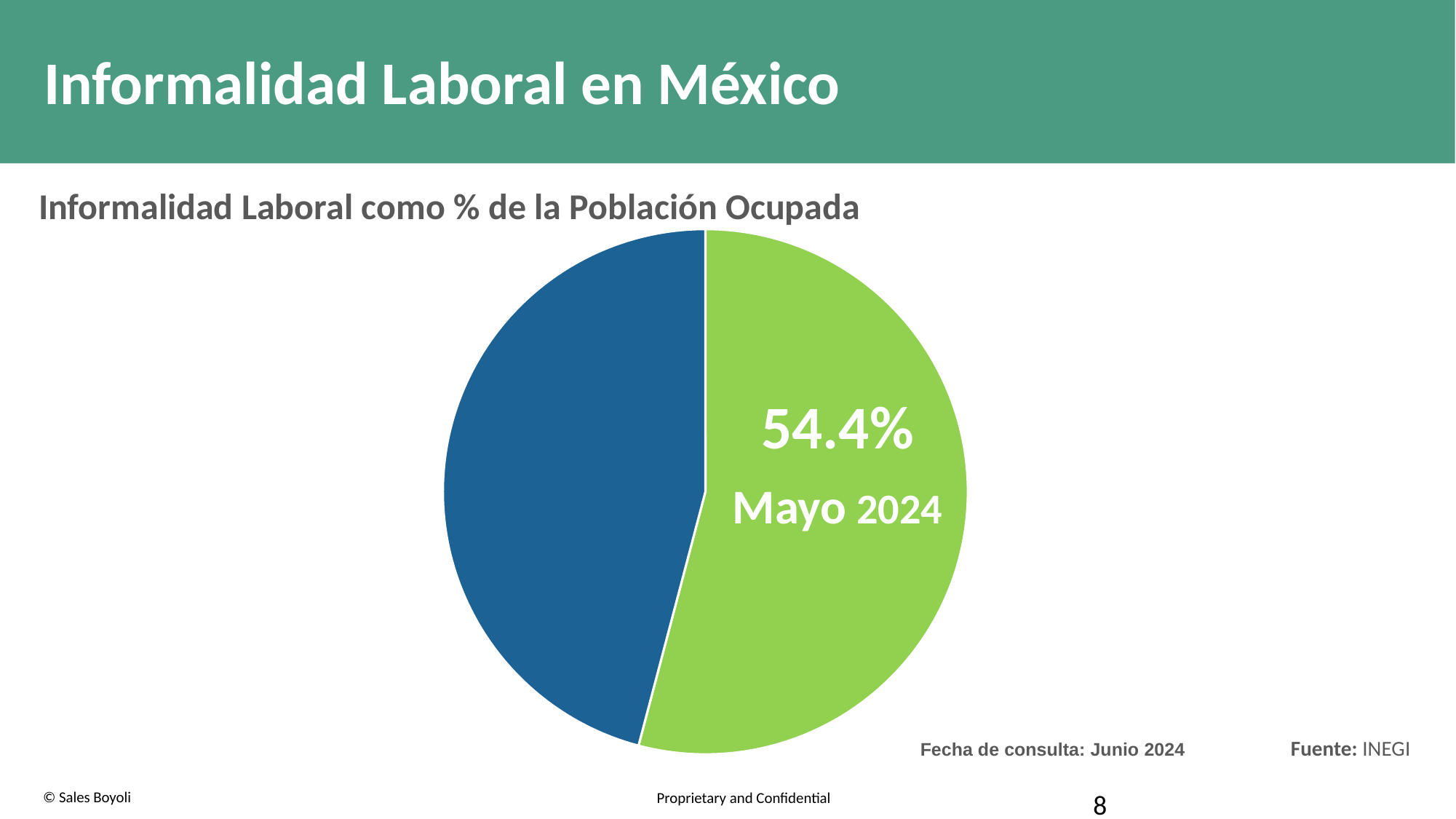
What is the title of the chart on the slide? Informalidad Laboral como % de la Población Ocupada What percentage is printed on the green slice of the pie chart? 54.4% What kind of chart is shown on the slide? Pie chart How many slices does the pie chart have? 2 What share of the pie does the slice labelled Mayo 2024 represent? 54.4% Which slice of the pie chart is larger, the green one or the blue one? The green one Which slice is the largest in the pie chart? The green slice (54.4%, Mayo 2024) Is the share of the green slice greater or less than 50%? greater Which month and year does the labelled slice of the pie chart refer to? Mayo 2024 What colour is the slice that carries the 54.4% label? Green Is the share of the blue slice greater or less than 50%? less